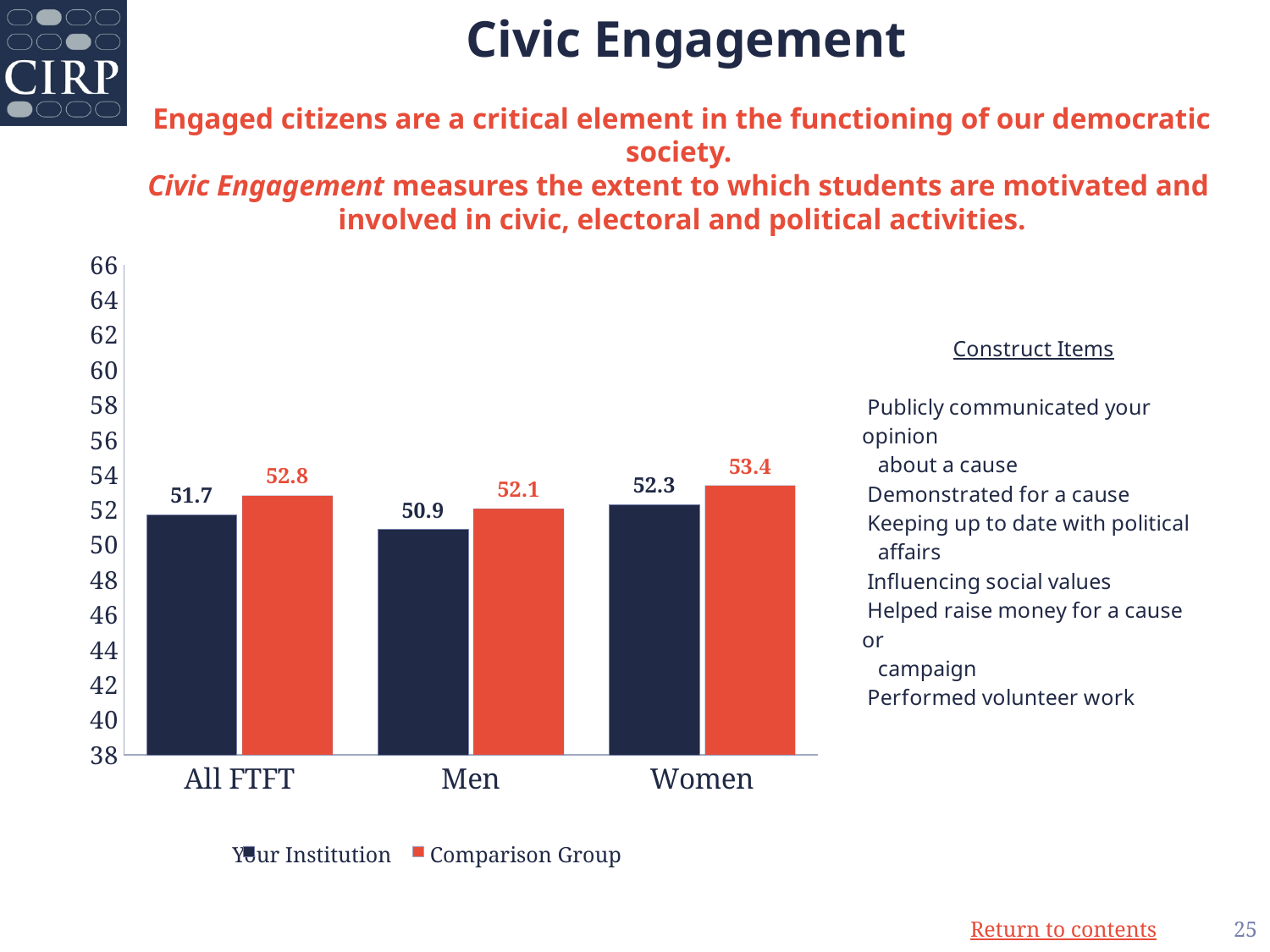
Is the Your Institution value for Women greater or less than 50? greater What is the Your Institution value for All FTFT? 51.7 How many categories are shown on the x axis? 3 What kind of chart is shown on the slide? bar chart Which category has the highest Comparison Group value? Women What is the difference between the Comparison Group and Your Institution values for Men? 1.2 How many series does the legend list? 2 For Women, which is larger: Your Institution or Comparison Group? Comparison Group What is the Your Institution value for Men? 50.9 What colour are the Comparison Group bars? orange-red Which category has the lowest Your Institution value? Men What is the Comparison Group value for Women? 53.4